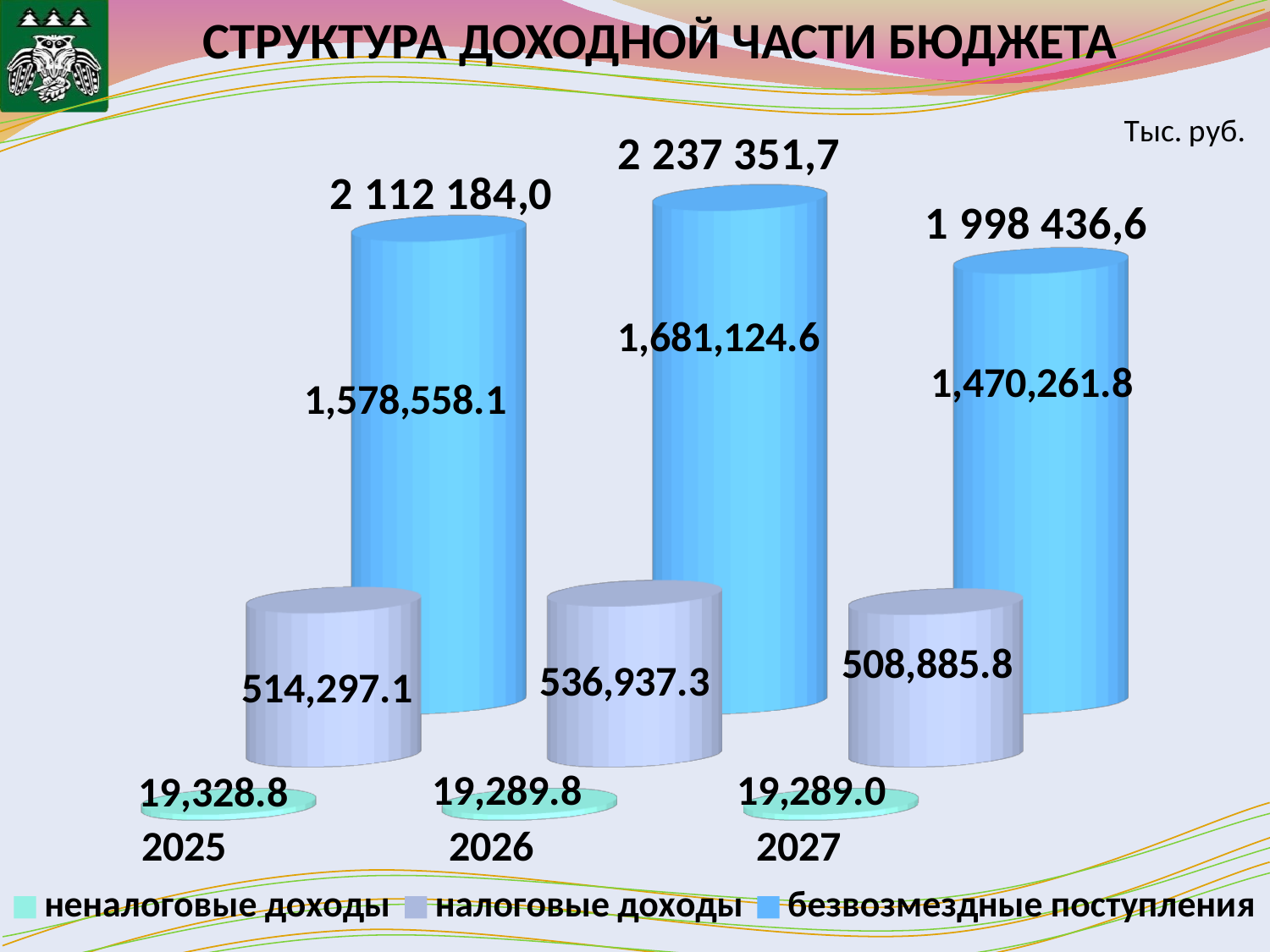
In which year is безвозмездные поступления the lowest? 2027 What unit is indicated in the top right corner of the chart? Тыс. руб. How many years are shown on the x axis? 3 What is the total shown above the 2026 bars? 2 237 351,7 What is the difference between безвозмездные поступления in 2026 and in 2025? 102,566.5 What is the value of неналоговые доходы for 2027? 19,289.0 What kind of chart is shown on the slide? bar chart What is the value of налоговые доходы for 2026? 536,937.3 How many series does the legend list? 3 What is the value of безвозмездные поступления for 2025? 1,578,558.1 Which is larger: налоговые доходы in 2025 or in 2027? 2025 In which year is безвозмездные поступления the highest? 2026